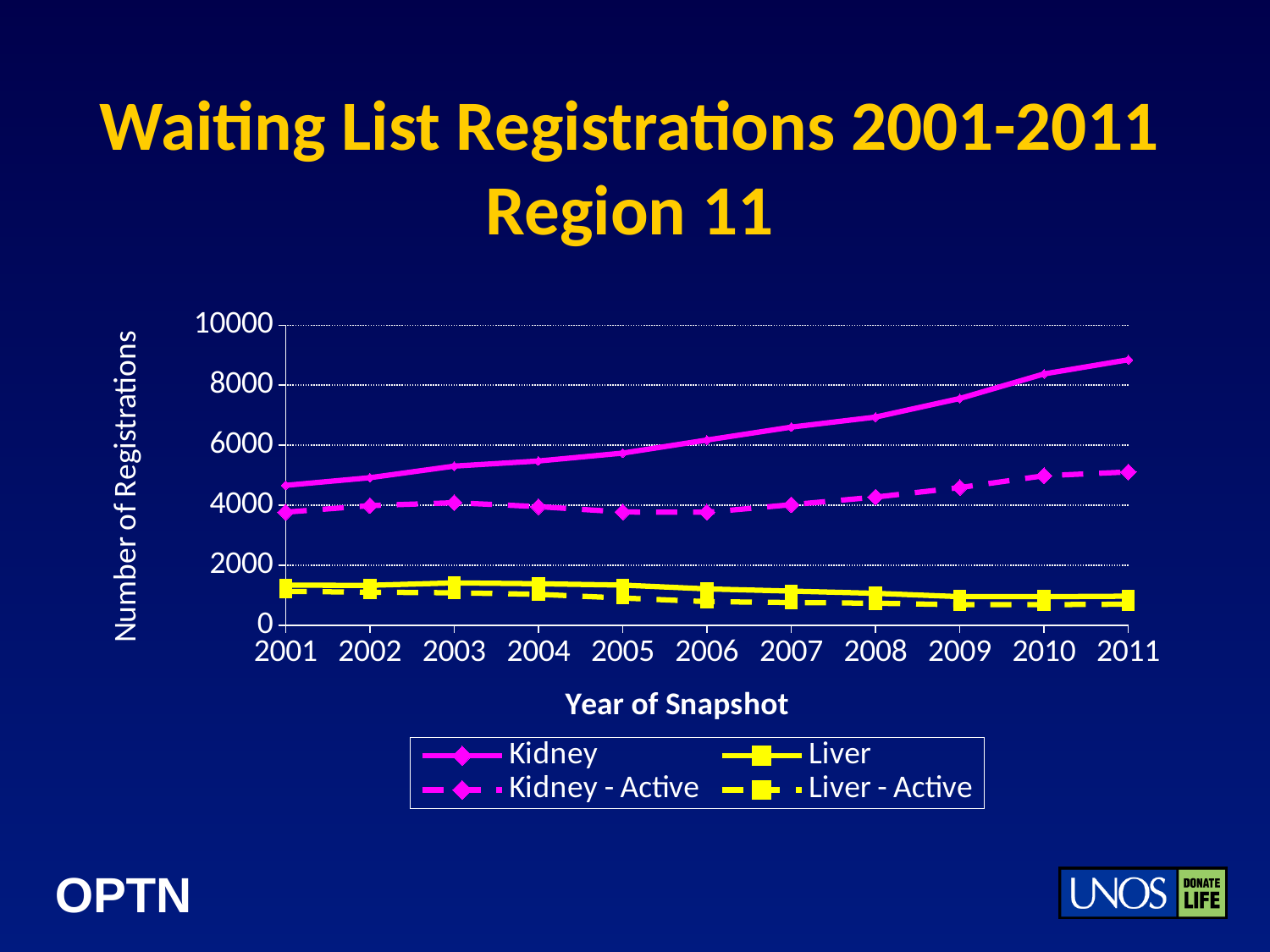
Is the Kidney value for 2001 greater or less than 6000? less Does the Liver series rise or fall from 2001 to 2011? Falls What kind of chart is shown on the slide? Line chart What is the label of the x axis? Year of Snapshot Is the Liver value for 2001 greater or less than 2000? less Is the Kidney - Active value for 2011 greater or less than 4000? greater In 2011, which series has the larger value, Kidney or Liver? Kidney In which year does the Kidney series reach its highest value? 2011 How many series does the legend list? 4 Does the Kidney series rise or fall from 2001 to 2011? Rises How many years are plotted along the x axis? 11